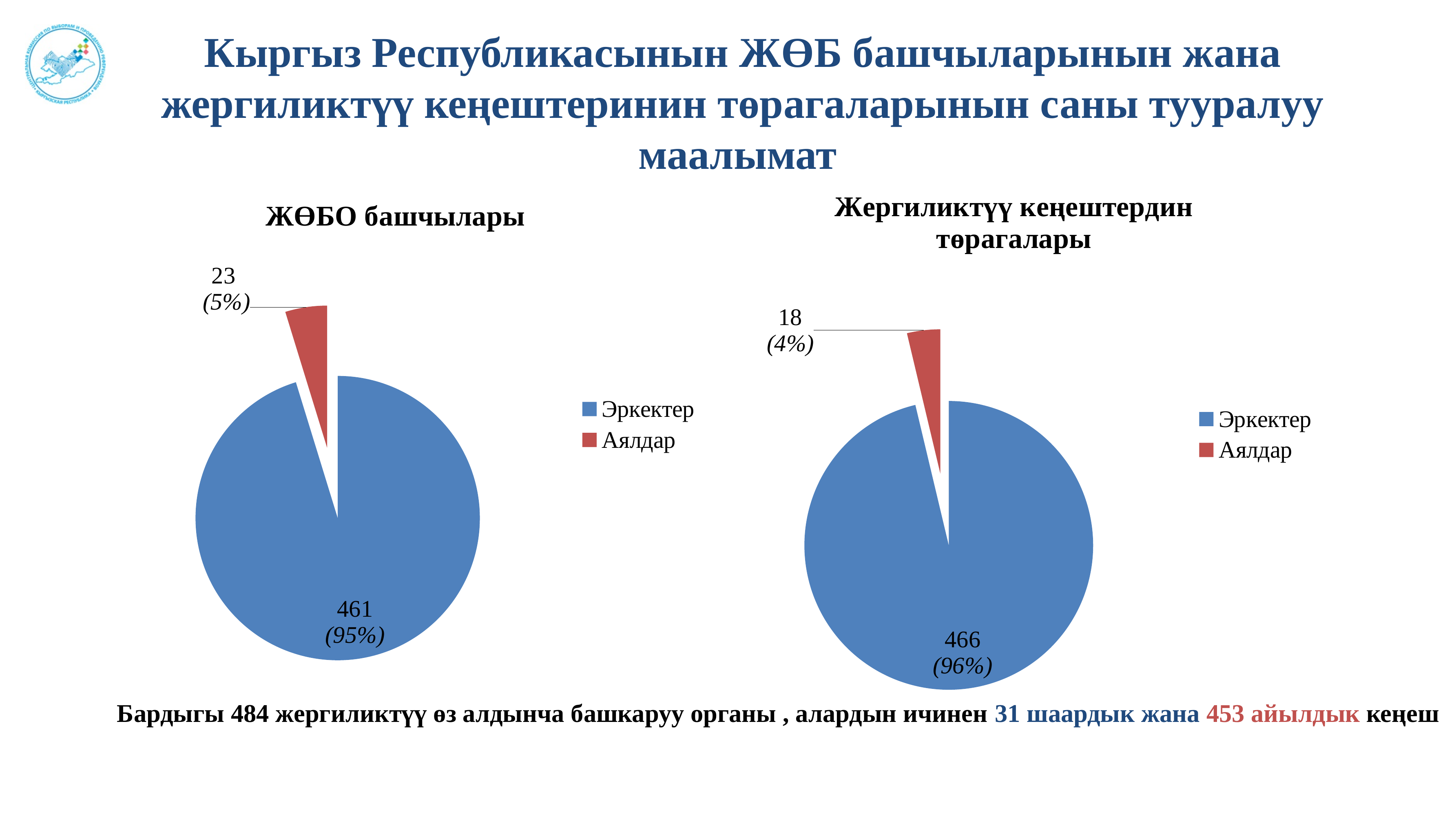
In the right chart titled "Жергиликтүү кеңештердин төрагалары", what is the difference between the values for Эркектер and Аялдар? 448 How many categories does the legend of the right chart titled "Жергиликтүү кеңештердин төрагалары" list? 2 In the left chart titled "ЖӨБО башчылары", what is the difference between the values for Эркектер and Аялдар? 438 In the right chart titled "Жергиликтүү кеңештердин төрагалары", which category is the smallest? Аялдар In the left chart titled "ЖӨБО башчылары", which category is the largest? Эркектер In the left chart titled "ЖӨБО башчылары", what share of the pie does Аялдар represent? 5% In the right chart titled "Жергиликтүү кеңештердин төрагалары", what share of the pie does Эркектер represent? 96% In the left chart titled "ЖӨБО башчылары", what is the value for Эркектер? 461 In the left chart titled "ЖӨБО башчылары", what is the value for Аялдар? 23 What kind of chart is the left chart titled "ЖӨБО башчылары"? Pie chart In the right chart titled "Жергиликтүү кеңештердин төрагалары", what is the value for Аялдар? 18 In the right chart titled "Жергиликтүү кеңештердин төрагалары", what is the value for Эркектер? 466